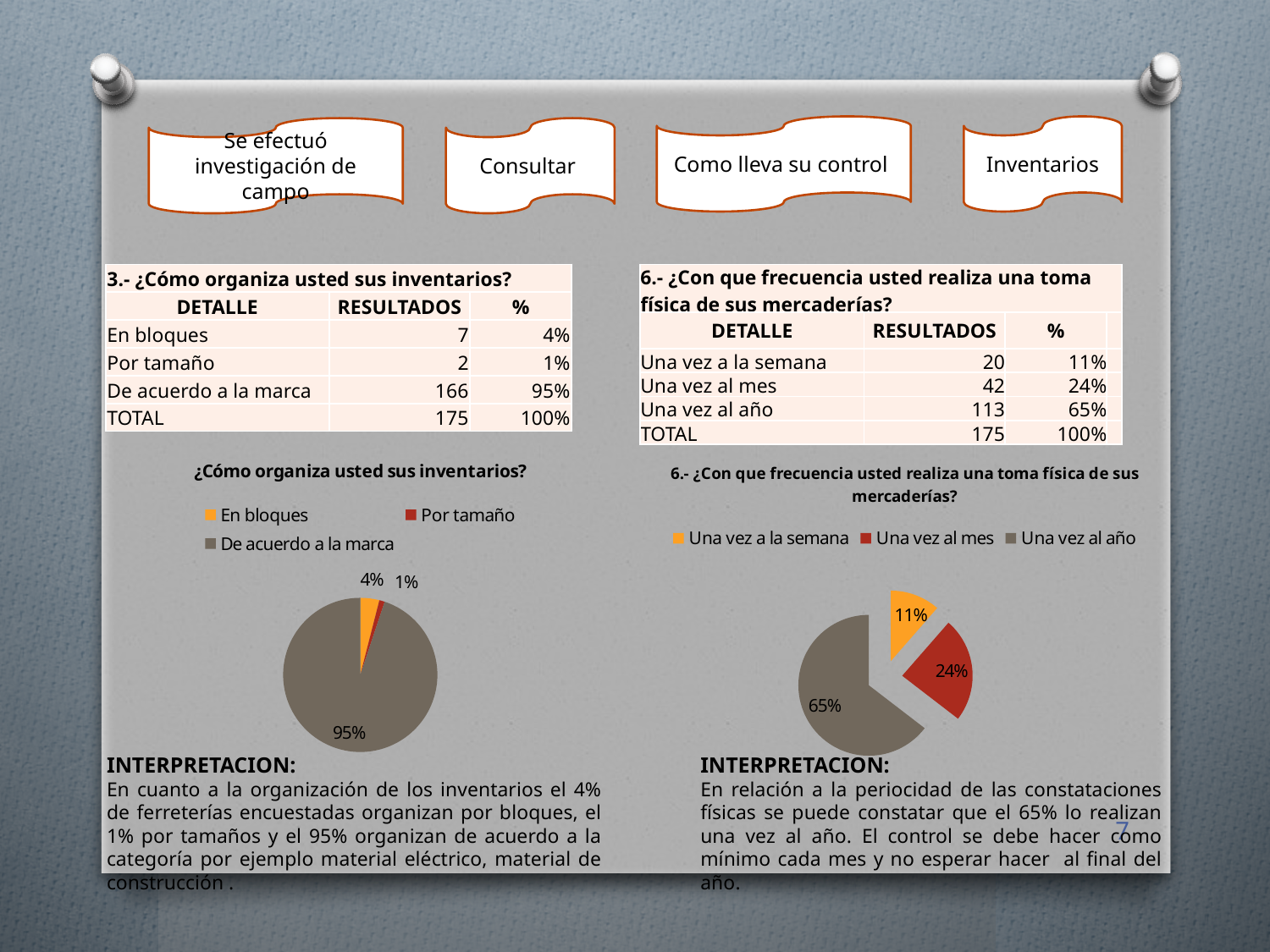
In the left pie chart '¿Cómo organiza usted sus inventarios?', what share is labelled for 'En bloques'? 4% In the left pie chart '¿Cómo organiza usted sus inventarios?', what is the difference between the shares for 'De acuerdo a la marca' and 'En bloques'? 91% In the right pie chart '6.- ¿Con que frecuencia usted realiza una toma física de sus mercaderías?', which category has the largest slice? Una vez al año In the left pie chart '¿Cómo organiza usted sus inventarios?', how many slices does the pie have? 3 In the left pie chart '¿Cómo organiza usted sus inventarios?', what share is labelled for 'De acuerdo a la marca'? 95% What type of chart is used on the left side of the slide for '¿Cómo organiza usted sus inventarios?'? Pie chart In the right pie chart '6.- ¿Con que frecuencia usted realiza una toma física de sus mercaderías?', what share is labelled for 'Una vez al mes'? 24% In the left pie chart '¿Cómo organiza usted sus inventarios?', which category has the smallest slice? Por tamaño In the right pie chart '6.- ¿Con que frecuencia usted realiza una toma física de sus mercaderías?', which is larger: 'Una vez a la semana' or 'Una vez al mes'? Una vez al mes How many entries does the legend of the right pie chart '6.- ¿Con que frecuencia usted realiza una toma física de sus mercaderías?' list? 3 In the right pie chart '6.- ¿Con que frecuencia usted realiza una toma física de sus mercaderías?', what share is labelled for 'Una vez al año'? 65% In the right pie chart '6.- ¿Con que frecuencia usted realiza una toma física de sus mercaderías?', what is the difference between the shares for 'Una vez al año' and 'Una vez al mes'? 41%